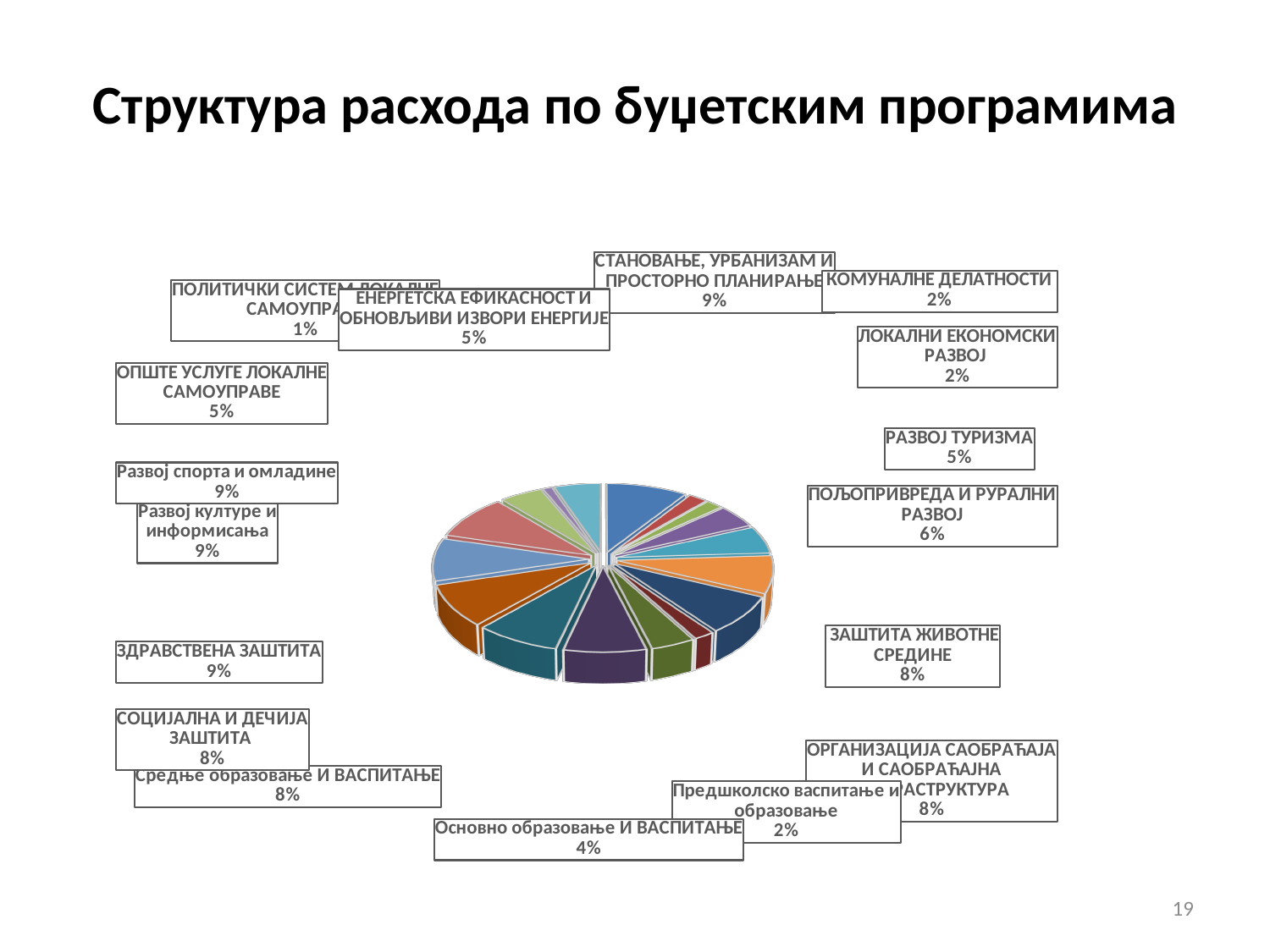
What share of expenditure goes to ПОЉОПРИВРЕДА И РУРАЛНИ РАЗВОЈ? 6% What percentage is shown for ЕНЕРГЕТСКА ЕФИКАСНОСТ И ОБНОВЉИВИ ИЗВОРИ ЕНЕРГИЈЕ? 5% Which has a larger share, РАЗВОЈ ТУРИЗМА or ПОЉОПРИВРЕДА И РУРАЛНИ РАЗВОЈ? ПОЉОПРИВРЕДА И РУРАЛНИ РАЗВОЈ What kind of chart is shown on the slide? pie chart What percentage is shown for ЗАШТИТА ЖИВОТНЕ СРЕДИНЕ? 8% What is the difference in percentage points between ЗДРАВСТВЕНА ЗАШТИТА and Основно образовање И ВАСПИТАЊЕ? 5 percentage points Which has a larger share, Предшколско васпитање и образовање or Средње образовање И ВАСПИТАЊЕ? Средње образовање И ВАСПИТАЊЕ What share of expenditure goes to ЗДРАВСТВЕНА ЗАШТИТА? 9% What percentage is shown for Основно образовање И ВАСПИТАЊЕ? 4% What is the title of the slide containing the pie chart? Структура расхода по буџетским програмима What is the smallest percentage shown for any program in the pie chart? 1% What percentage is shown for КОМУНАЛНЕ ДЕЛАТНОСТИ? 2%